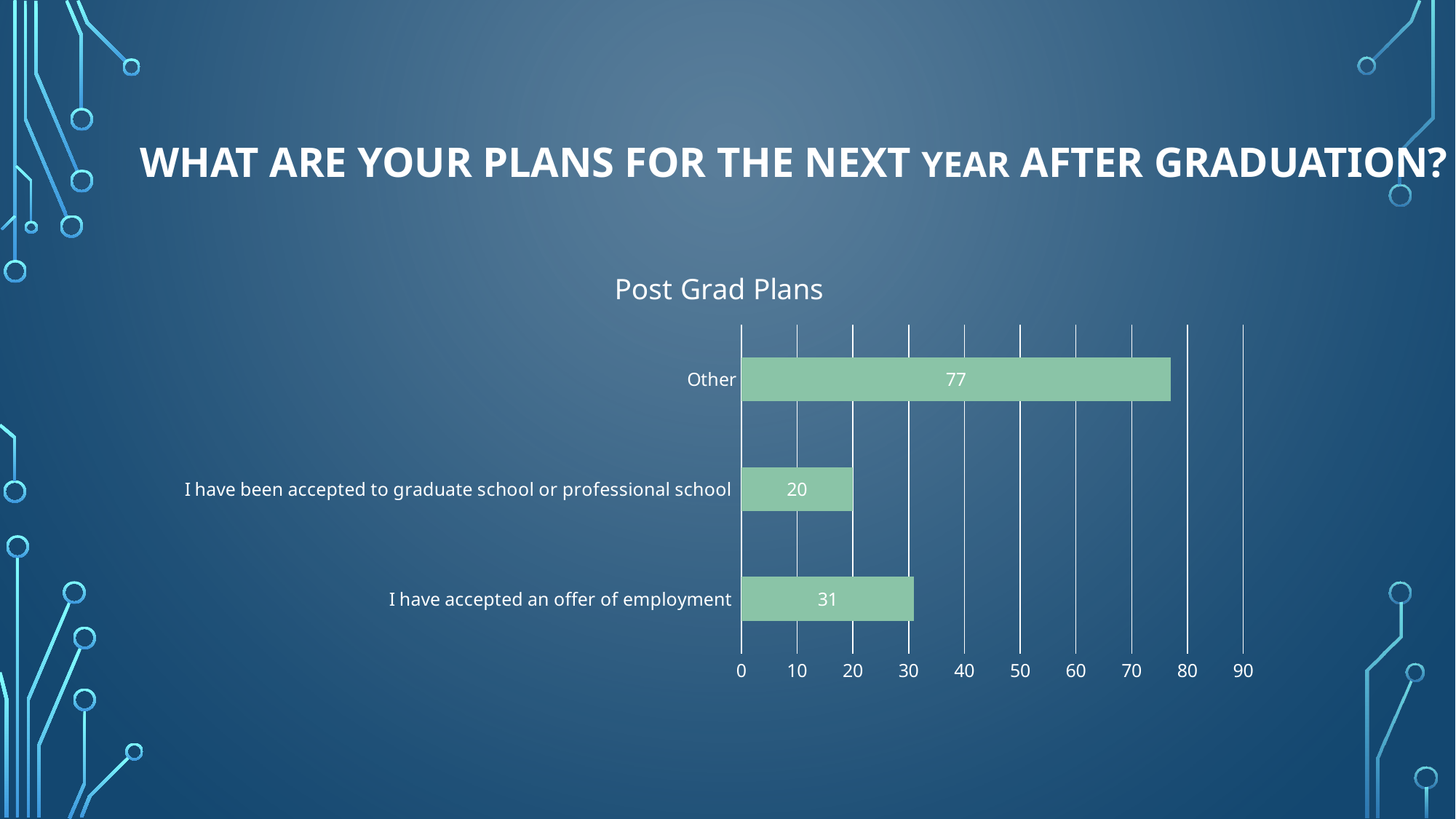
Which is larger: the value for "I have accepted an offer of employment" or the value for "I have been accepted to graduate school or professional school"? I have accepted an offer of employment What is the difference between the value for "I have accepted an offer of employment" and the value for "I have been accepted to graduate school or professional school"? 11 What is the value for "Other" in the Post Grad Plans chart? 77 What is the value for "I have been accepted to graduate school or professional school"? 20 What is the title of the chart on the slide? Post Grad Plans What is the difference between the value for "Other" and the value for "I have accepted an offer of employment"? 46 Is the value for "Other" greater or less than 70? greater How many categories are shown in the Post Grad Plans chart? 3 Which category has the lowest value in the Post Grad Plans chart? I have been accepted to graduate school or professional school What kind of chart is shown on the slide? Bar chart Which category has the highest value in the Post Grad Plans chart? Other What is the value for "I have accepted an offer of employment"? 31